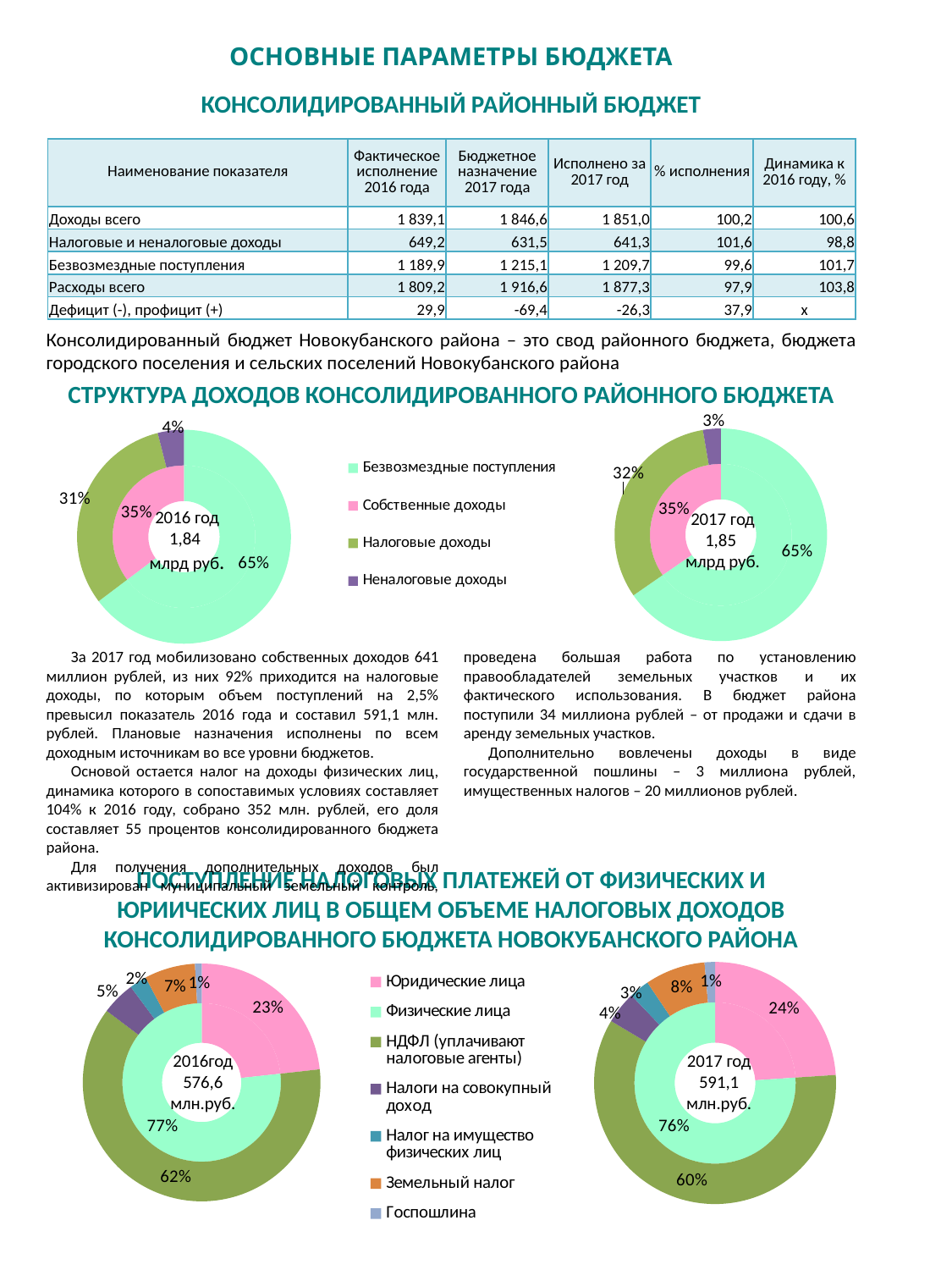
In the 2016 chart under 'Поступление налоговых платежей от физических и юридических лиц', which is larger: the share for Земельный налог or the share for Налоги на совокупный доход? Земельный налог In the 2017 chart under 'Поступление налоговых платежей от физических и юридических лиц', what share is labelled for НДФЛ (уплачивают налоговые агенты)? 60% What total value is printed in the centre of the 2017 chart under 'Структура доходов консолидированного районного бюджета'? 1,85 млрд руб. In the 2016 doughnut chart under 'Структура доходов консолидированного районного бюджета', what share is labelled for Безвозмездные поступления? 65% How many series does the legend list for the charts under 'Структура доходов консолидированного районного бюджета'? 4 In the 2017 chart under 'Поступление налоговых платежей от физических и юридических лиц', what share is labelled for Земельный налог? 8% In the 2017 doughnut chart under 'Структура доходов консолидированного районного бюджета', what share is labelled for Неналоговые доходы? 3% What kind of chart is used in the section 'Поступление налоговых платежей от физических и юридических лиц'? Doughnut (pie) chart In the 2016 chart under 'Поступление налоговых платежей от физических и юридических лиц', what share is labelled for Юридические лица? 23% How many series does the legend list for the charts under 'Поступление налоговых платежей от физических и юридических лиц'? 7 What total value is printed in the centre of the 2017 chart under 'Поступление налоговых платежей от физических и юридических лиц'? 591,1 млн.руб. In the 2016 doughnut chart under 'Структура доходов консолидированного районного бюджета', what share is labelled for Налоговые доходы? 31%